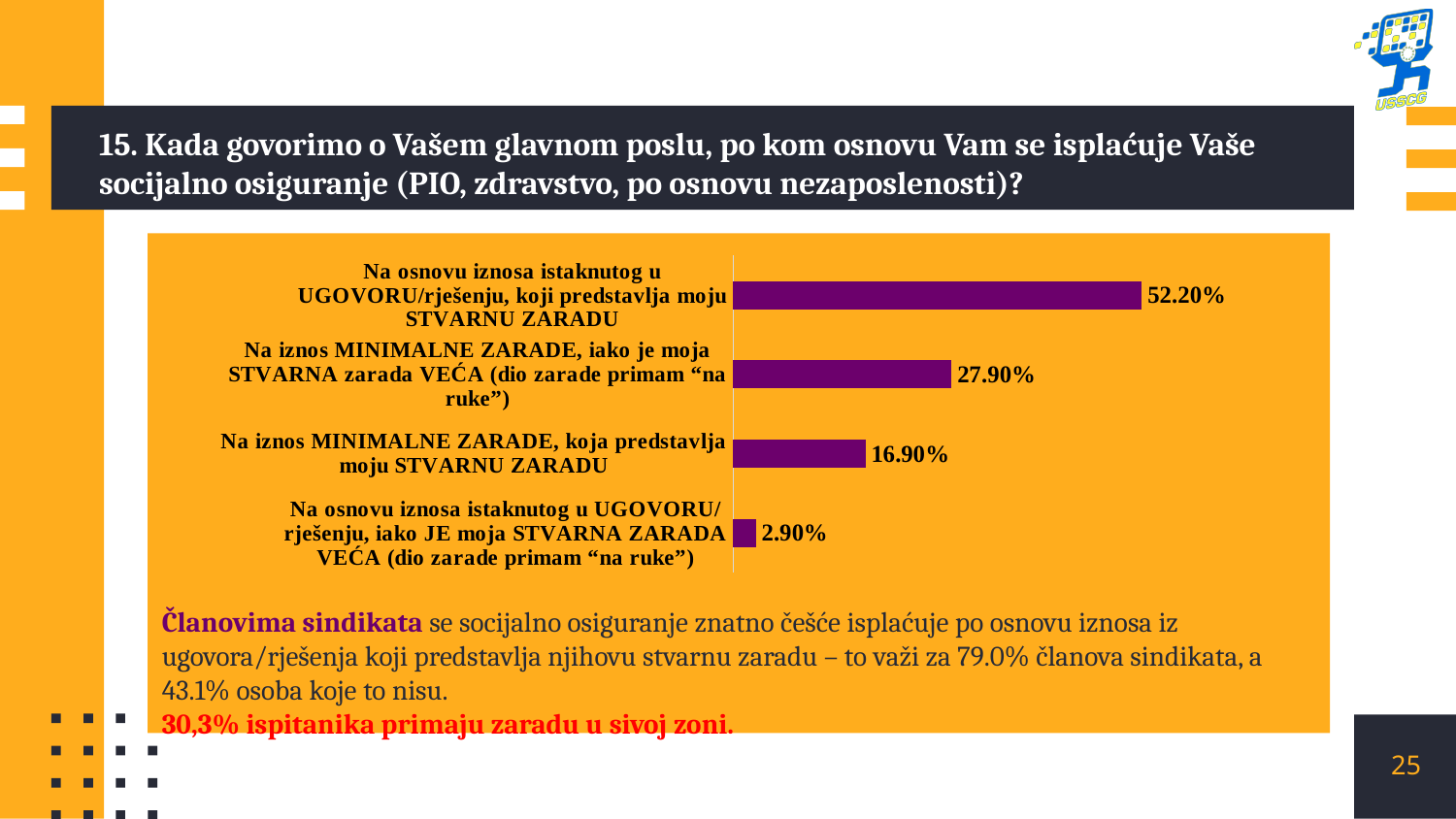
How many categories are shown in the chart? 4 What is the difference between the values for "Na iznos MINIMALNE ZARADE, iako je moja STVARNA zarada VEĆA" and "Na iznos MINIMALNE ZARADE, koja predstavlja moju STVARNU ZARADU"? 11.00% What is the value for "Na osnovu iznosa istaknutog u UGOVORU/rješenju, iako JE moja STVARNA ZARADA VEĆA (dio zarade primam "na ruke")"? 2.90% Which category has the lowest value in the chart? Na osnovu iznosa istaknutog u UGOVORU/rješenju, iako JE moja STVARNA ZARADA VEĆA (dio zarade primam "na ruke") What is the value for "Na iznos MINIMALNE ZARADE, iako je moja STVARNA zarada VEĆA (dio zarade primam "na ruke")"? 27.90% Which is larger: the value for "Na iznos MINIMALNE ZARADE, koja predstavlja moju STVARNU ZARADU" or the value for "Na osnovu iznosa istaknutog u UGOVORU/rješenju, iako JE moja STVARNA ZARADA VEĆA"? Na iznos MINIMALNE ZARADE, koja predstavlja moju STVARNU ZARADU What percentage of respondents have social insurance paid based on the amount stated in the contract/decision that represents their actual salary ("Na osnovu iznosa istaknutog u UGOVORU/rješenju, koji predstavlja moju STVARNU ZARADU")? 52.20% What colour are the bars in the chart? Purple What is the value for "Na iznos MINIMALNE ZARADE, koja predstavlja moju STVARNU ZARADU"? 16.90% What is the difference between the highest value (52.20%) and the second highest value (27.90%)? 24.30% Which category has the highest value in the chart? Na osnovu iznosa istaknutog u UGOVORU/rješenju, koji predstavlja moju STVARNU ZARADU What type of chart is shown on the slide? Bar chart